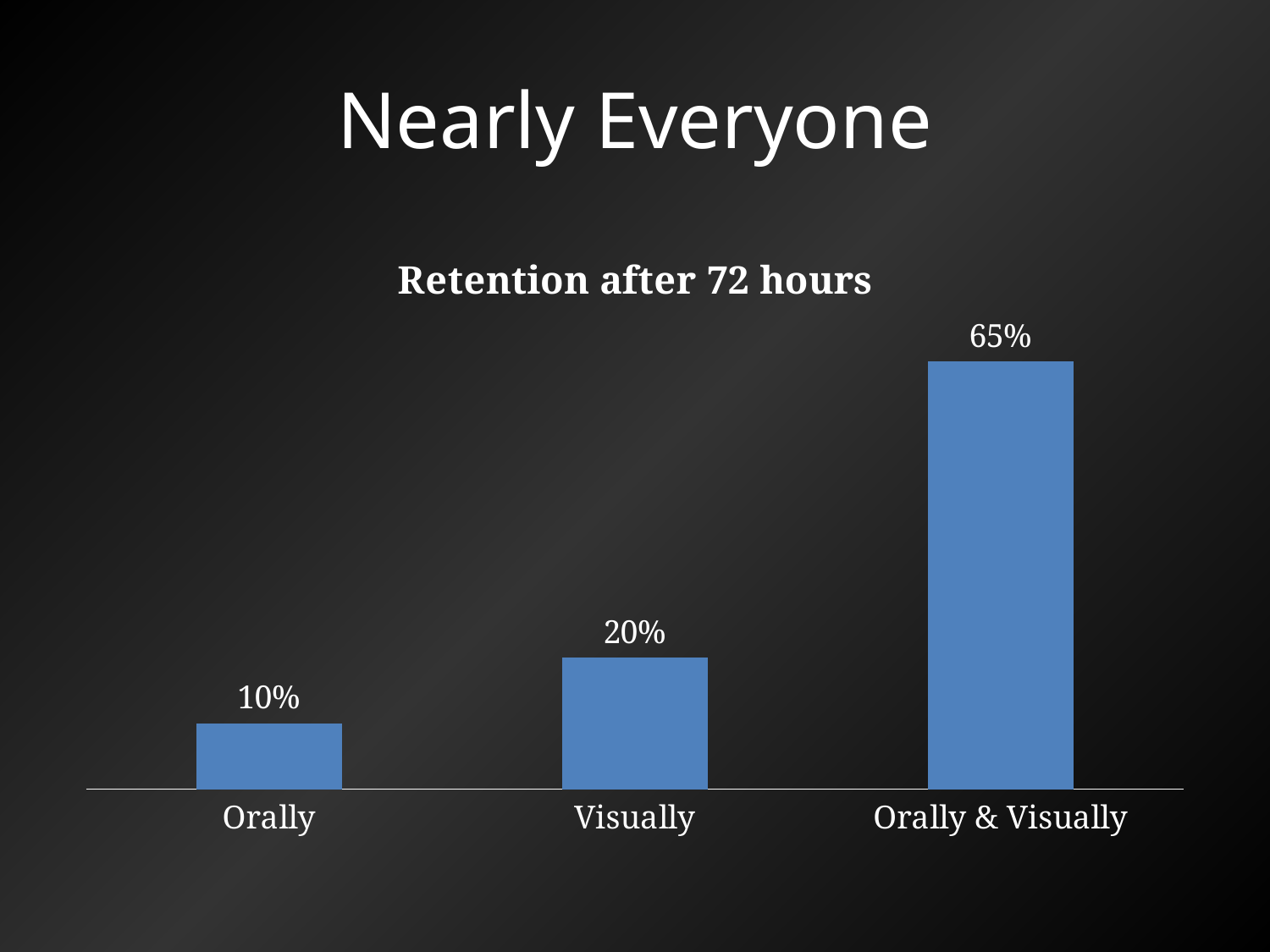
Which category has the highest retention after 72 hours? Orally & Visually Do the values rise or fall from left to right across the categories? Rise What kind of chart is shown on the slide? Bar chart What is the title of the chart? Retention after 72 hours What is the retention value for Orally & Visually? 65% What is the difference between the retention for Visually and the retention for Orally? 10% What is the difference between the retention for Orally & Visually and the retention for Visually? 45% Which category has the lowest retention after 72 hours? Orally What is the retention value for Orally? 10% Which is larger, the retention for Visually or the retention for Orally? Visually How many categories are shown in the chart? 3 What is the retention value for Visually? 20%